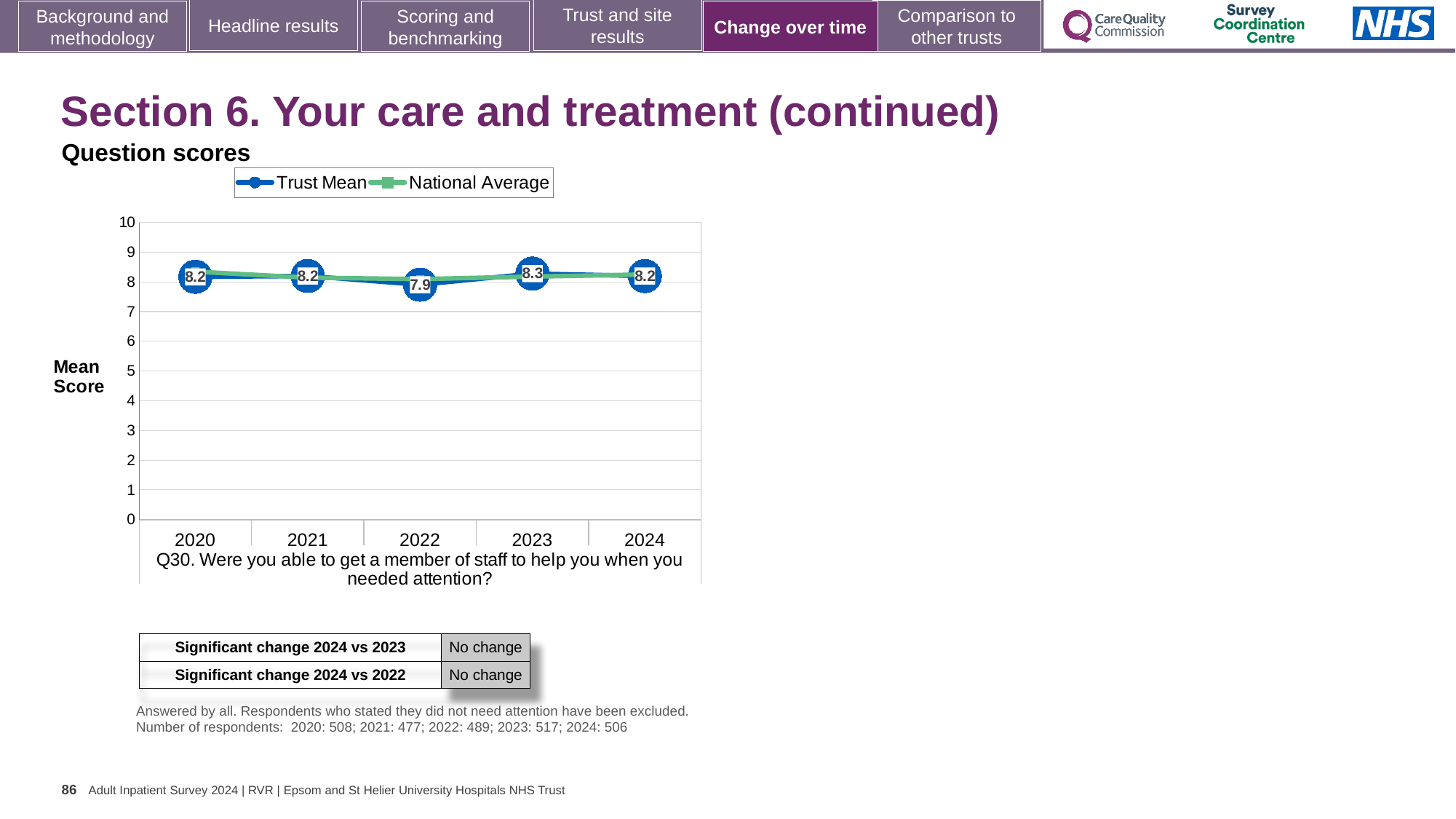
What is the difference between the Trust Mean scores for 2023 and 2022? 0.4 What is the Trust Mean score for 2023? 8.3 What is the Trust Mean score for 2024? 8.2 What is the Trust Mean score for 2020? 8.2 Which year has the larger Trust Mean score, 2022 or 2023? 2023 Is the National Average value for 2024 greater or less than 7? greater What kind of chart is shown on the slide? Line chart In which year is the Trust Mean score lowest? 2022 What is the Trust Mean score for 2022? 7.9 How many years are plotted on the x axis? 5 How many series does the legend list? 2 In which year is the Trust Mean score highest? 2023